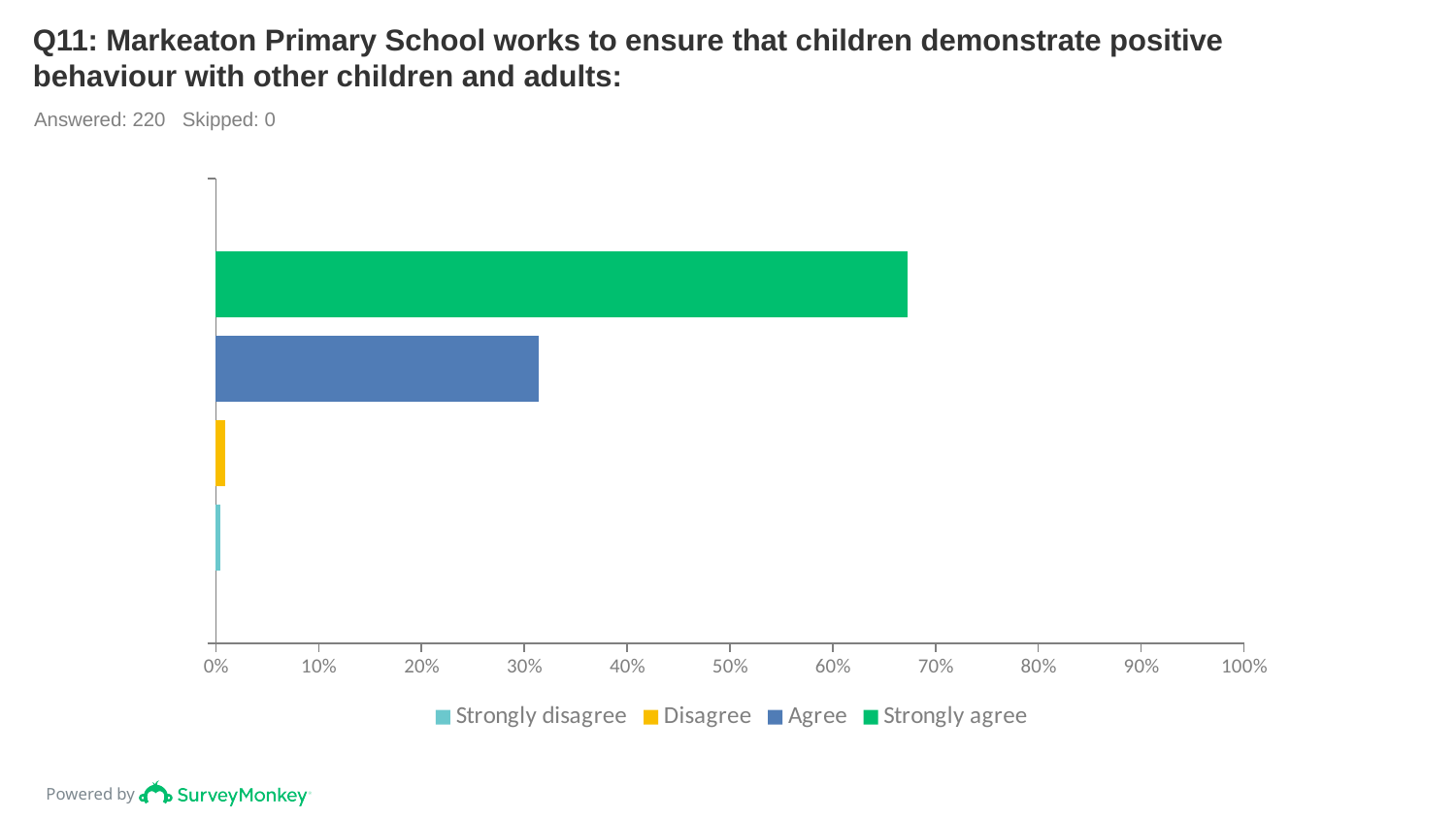
Is the value for Strongly agree greater or less than 70%? less Which is larger, the value for Agree or the value for Strongly agree? Strongly agree How many series does the legend list? 4 Is the value for Agree greater or less than 40%? less Which is larger, the value for Disagree or the value for Agree? Agree Is the value for Strongly agree greater or less than 60%? greater How many respondents answered this question according to the slide? 220 What kind of chart is shown on the slide? bar chart Which response option has the shortest bar? Strongly disagree What colour is the bar for Strongly agree? green Which response option has the longest bar? Strongly agree